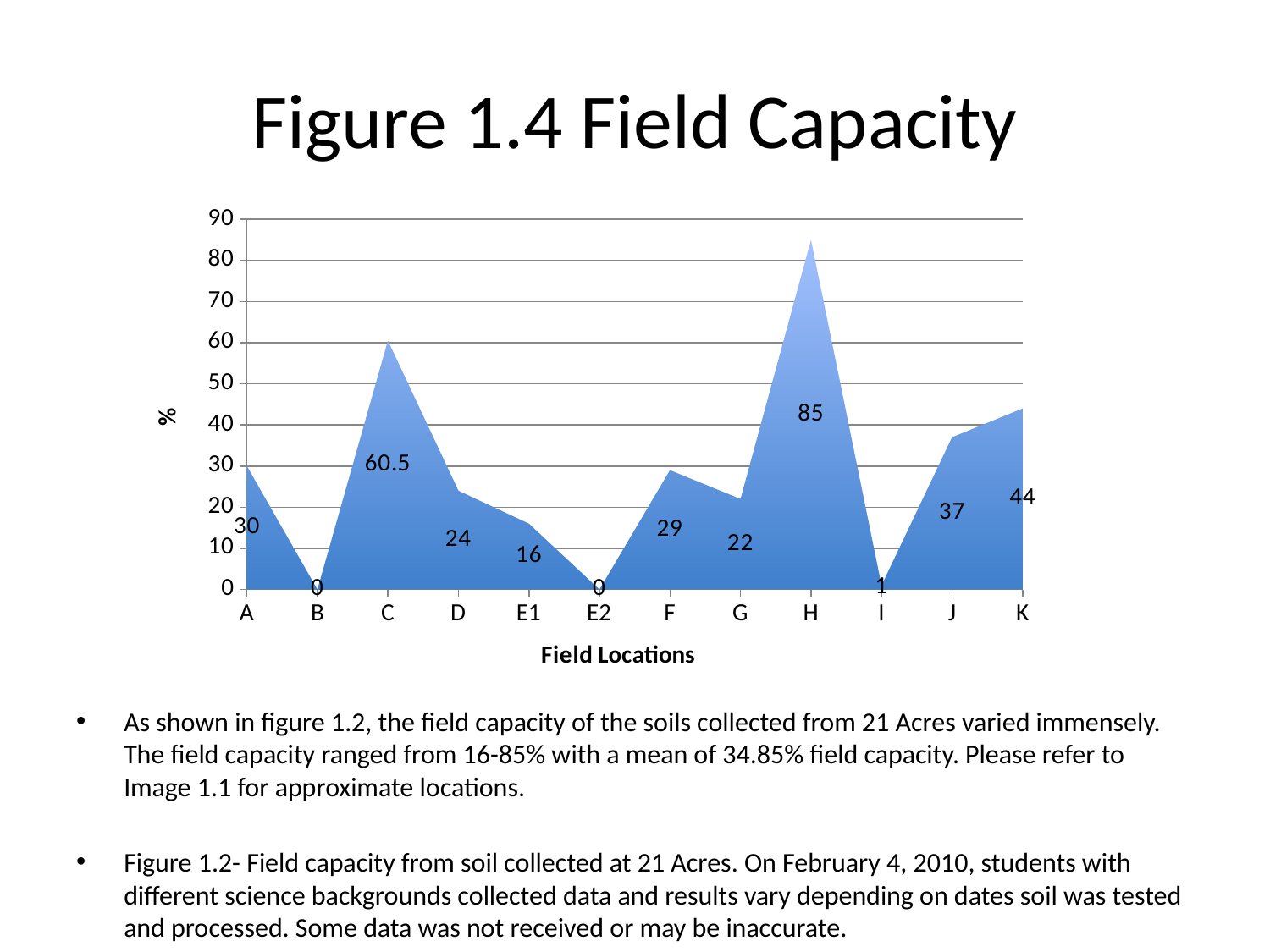
What kind of chart is shown on the slide? Area chart Is the value for location J greater or less than 30? greater What is the label of the x axis? Field Locations What is the field capacity value for location C? 60.5 What is the difference between the values for H and C? 24.5 What is the difference between the values for K and J? 7 Which has a larger value, location A or location D? A Which field locations have a value of 0? B and E2 What is the field capacity value for location H? 85 How many field locations are shown on the x axis? 12 What is the value shown for location E1? 16 Which field location has the highest field capacity? H